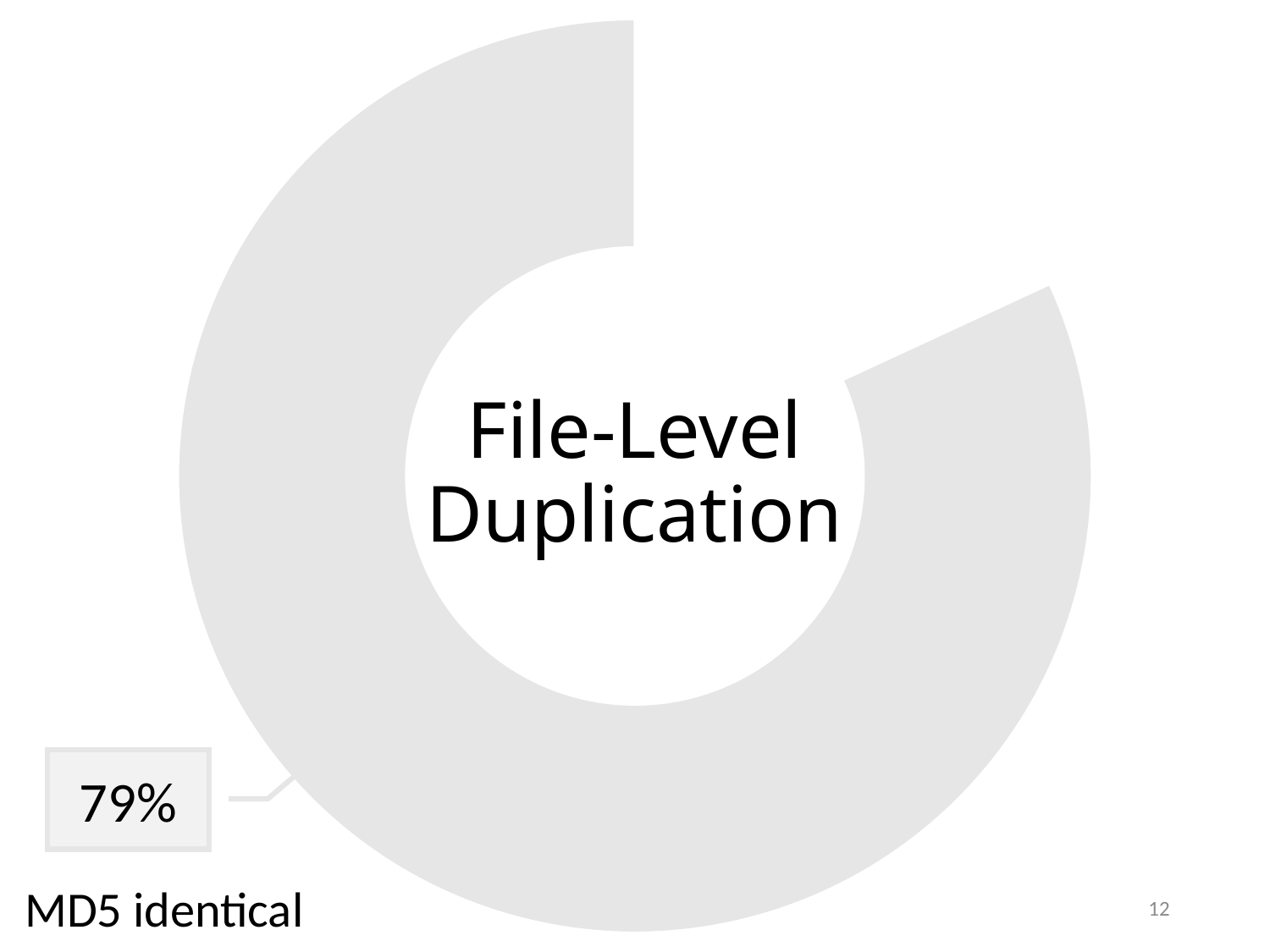
What share of the doughnut is not covered by the grey 79% slice? 21% What text appears below the 79% data label at the bottom left of the slide? MD5 identical What is the title shown in the centre of the chart? File-Level Duplication How many data labels are printed on the chart? 1 What percentage is printed on the data label of the chart? 79% What kind of chart is shown on the slide? doughnut chart Is the share of the grey slice greater or less than 50%? greater What share of the doughnut does the grey slice represent? 79%